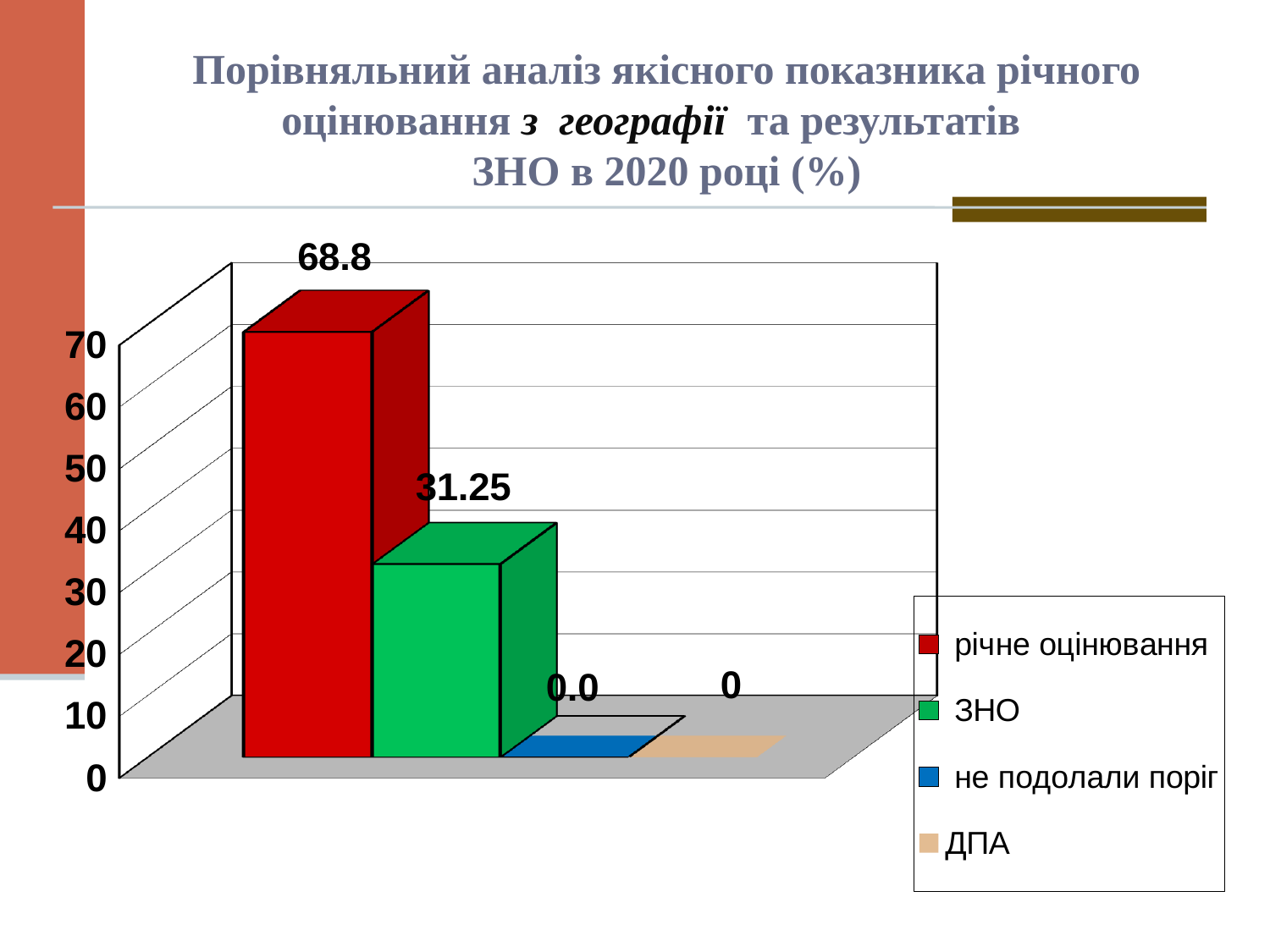
Which series has the highest value? річне оцінювання What is the difference between the values for річне оцінювання and ЗНО? 37.55 Is the value for ЗНО greater or less than 40? less What is the value for не подолали поріг? 0.0 Is the value for річне оцінювання greater or less than 60? greater What is the value for ДПА? 0 What is the value for річне оцінювання? 68.8 How many series does the legend list? 4 Which is larger, the value for річне оцінювання or the value for ЗНО? річне оцінювання What is the value for ЗНО? 31.25 What colour is the bar for ЗНО? green What kind of chart is shown on the slide? bar chart